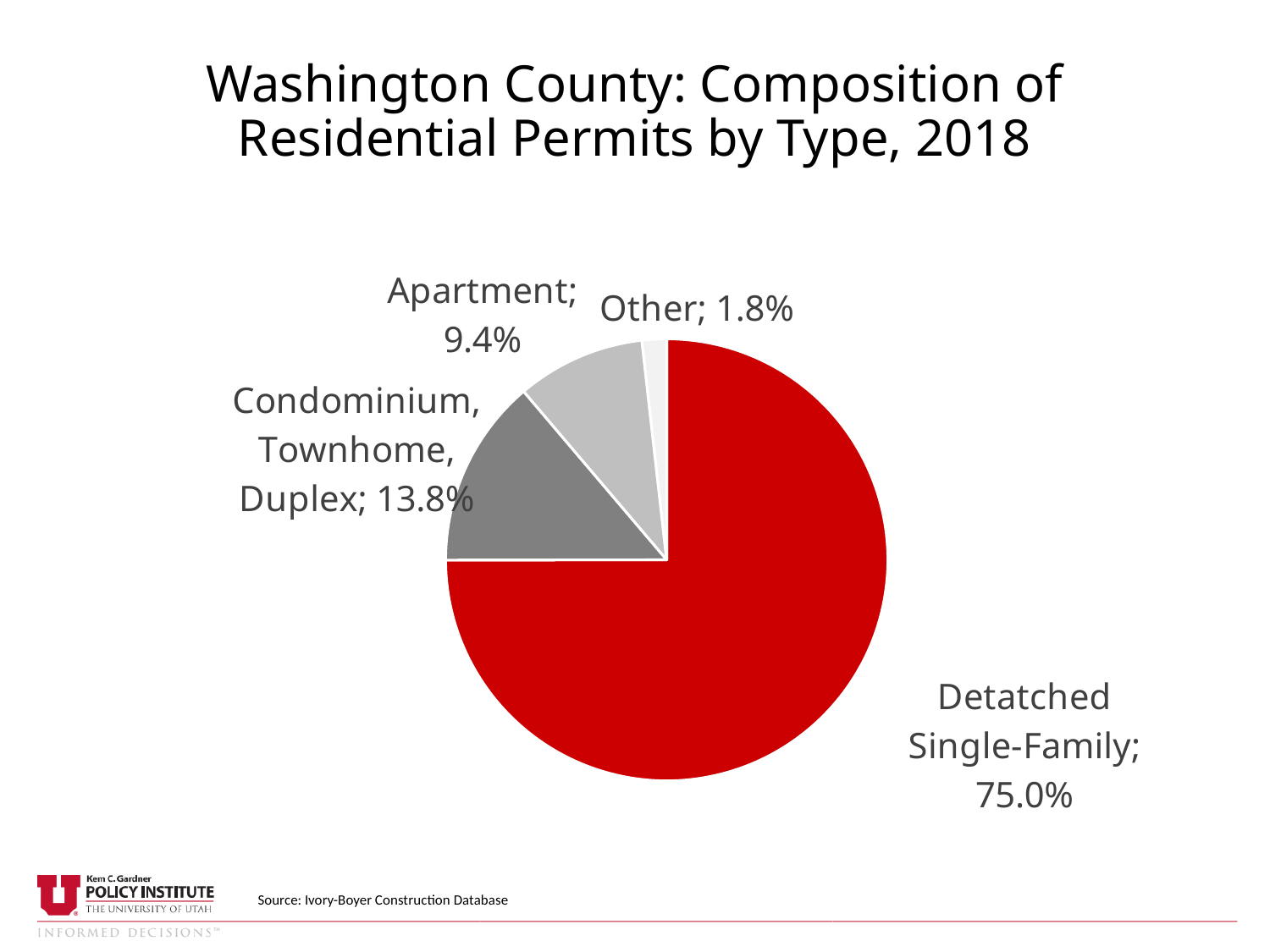
What kind of chart is shown on the slide? Pie chart What is the difference in percentage points between the Detatched Single-Family share and the Other share? 73.2 What share of residential permits is Detatched Single-Family? 75.0% Which permit type has the largest share of the pie? Detatched Single-Family What share of residential permits is Apartment? 9.4% Which permit type has the smallest share of the pie? Other What is the difference in percentage points between the Condominium, Townhome, Duplex share and the Apartment share? 4.4 Which is larger, the Apartment share or the Condominium, Townhome, Duplex share? Condominium, Townhome, Duplex What is the title of the chart? Washington County: Composition of Residential Permits by Type, 2018 What share of residential permits is Other? 1.8% What share of residential permits is Condominium, Townhome, Duplex? 13.8% How many slices does the pie chart have? 4